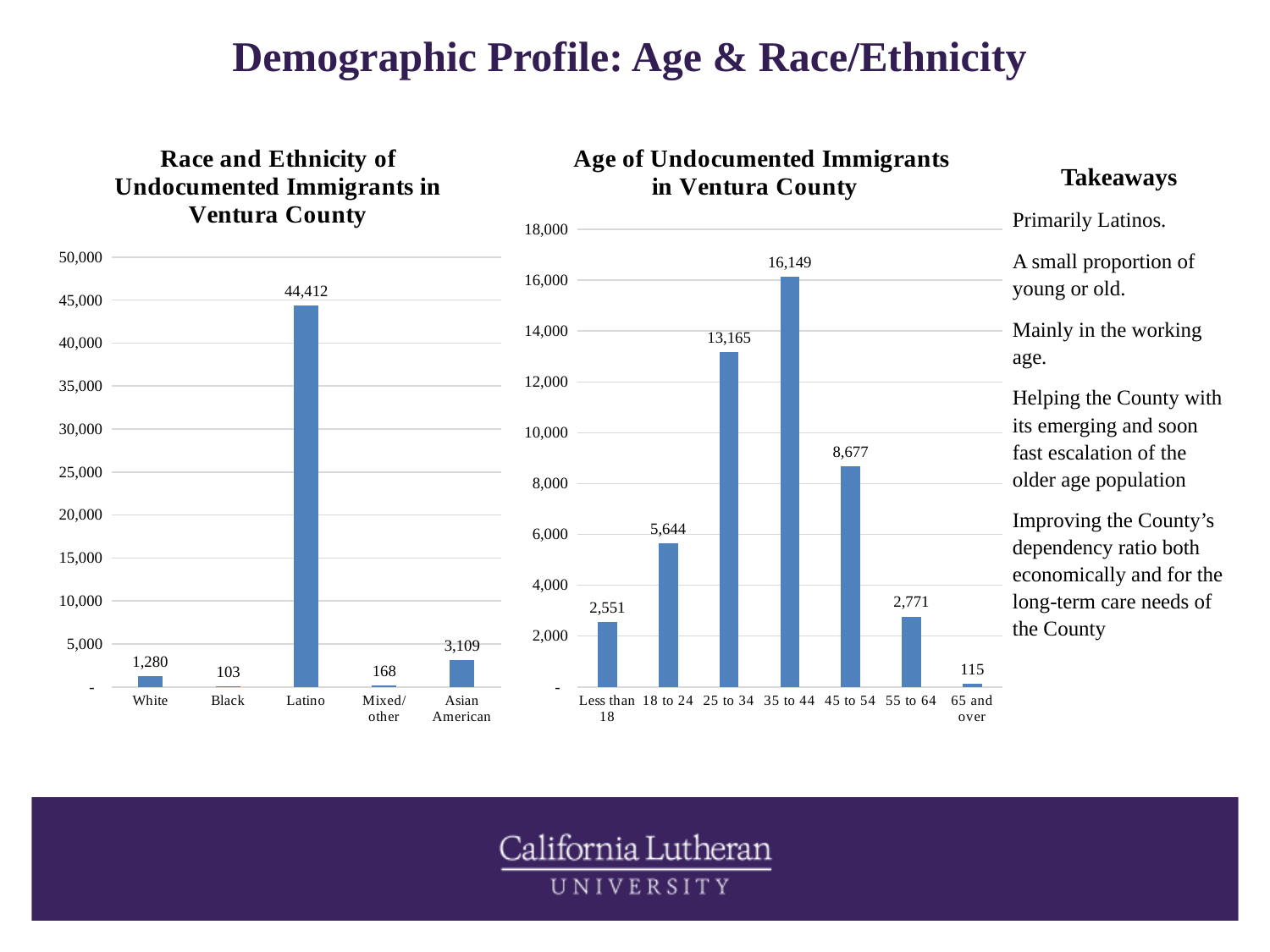
In the 'Age of Undocumented Immigrants in Ventura County' chart, what is the value for 35 to 44? 16,149 In the 'Age of Undocumented Immigrants in Ventura County' chart, which age group has the highest value? 35 to 44 In the 'Age of Undocumented Immigrants in Ventura County' chart, what is the difference between the values for 35 to 44 and 25 to 34? 2,984 What kind of chart is the 'Age of Undocumented Immigrants in Ventura County' chart? Bar chart In the 'Race and Ethnicity of Undocumented Immigrants in Ventura County' chart, what is the difference between the values for Asian American and White? 1,829 In the 'Age of Undocumented Immigrants in Ventura County' chart, which age group has the lowest value? 65 and over In the 'Age of Undocumented Immigrants in Ventura County' chart, what is the value for 18 to 24? 5,644 In the 'Age of Undocumented Immigrants in Ventura County' chart, how many age groups are shown on the x axis? 7 In the 'Race and Ethnicity of Undocumented Immigrants in Ventura County' chart, which is larger, the value for Mixed/other or the value for Black? Mixed/other In the 'Race and Ethnicity of Undocumented Immigrants in Ventura County' chart, which category has the lowest value? Black In the 'Race and Ethnicity of Undocumented Immigrants in Ventura County' chart, what is the value for Latino? 44,412 In the 'Race and Ethnicity of Undocumented Immigrants in Ventura County' chart, how many categories are shown on the x axis? 5